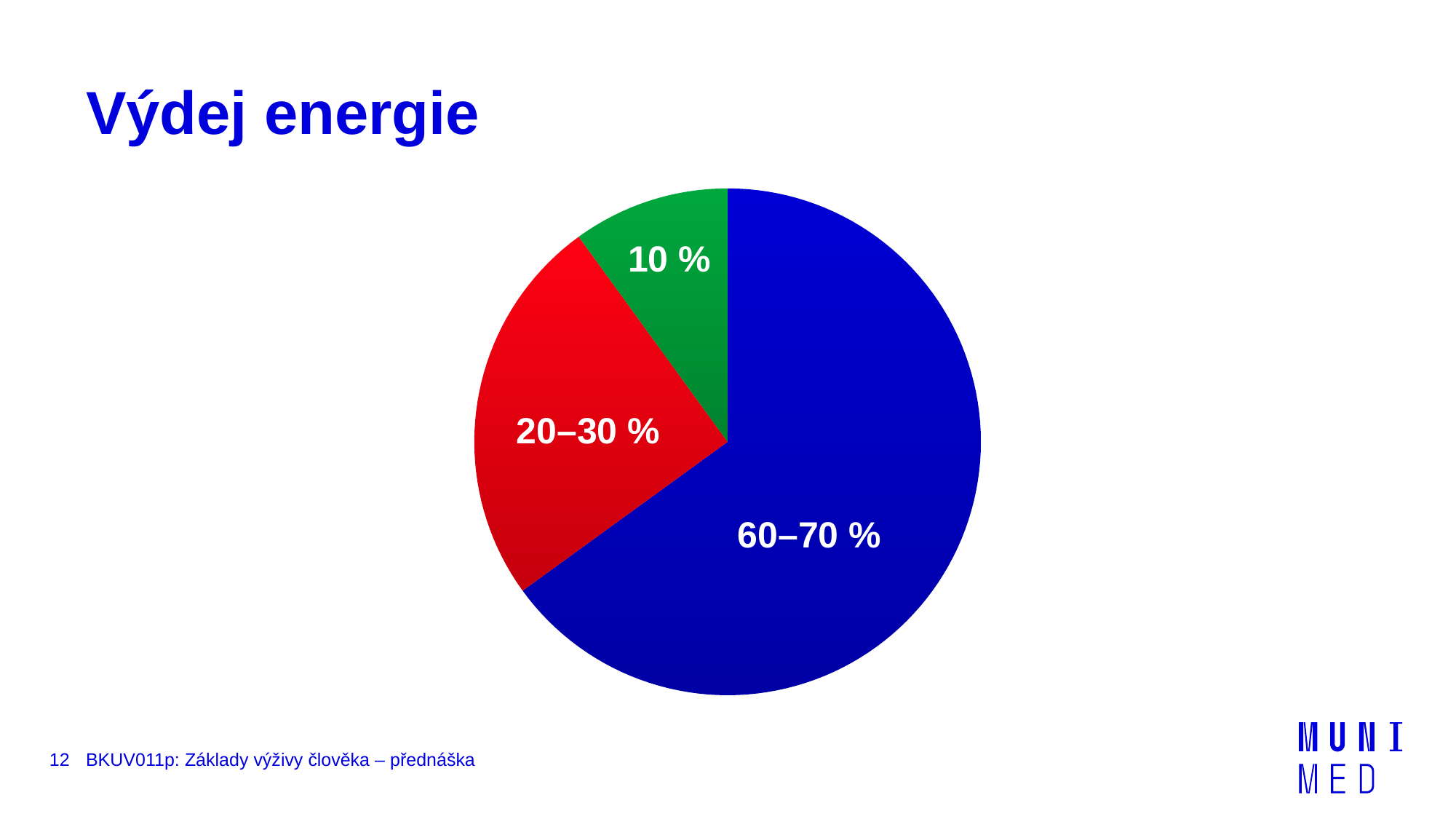
What is the label on the green slice of the pie chart? 10 % How many slices does the pie chart have? 3 What colour is the slice labelled 20–30 %? red What kind of chart is shown on the slide? pie chart What is the title of the slide containing the pie chart? Výdej energie Which slice of the pie chart is the largest? the blue slice (60–70 %) Which slice is larger, the red slice or the green slice? the red slice What is the label on the red slice of the pie chart? 20–30 % What is the label on the blue slice of the pie chart? 60–70 % What share of the pie does the green slice represent? 10 % Which slice of the pie chart is the smallest? the green slice (10 %)